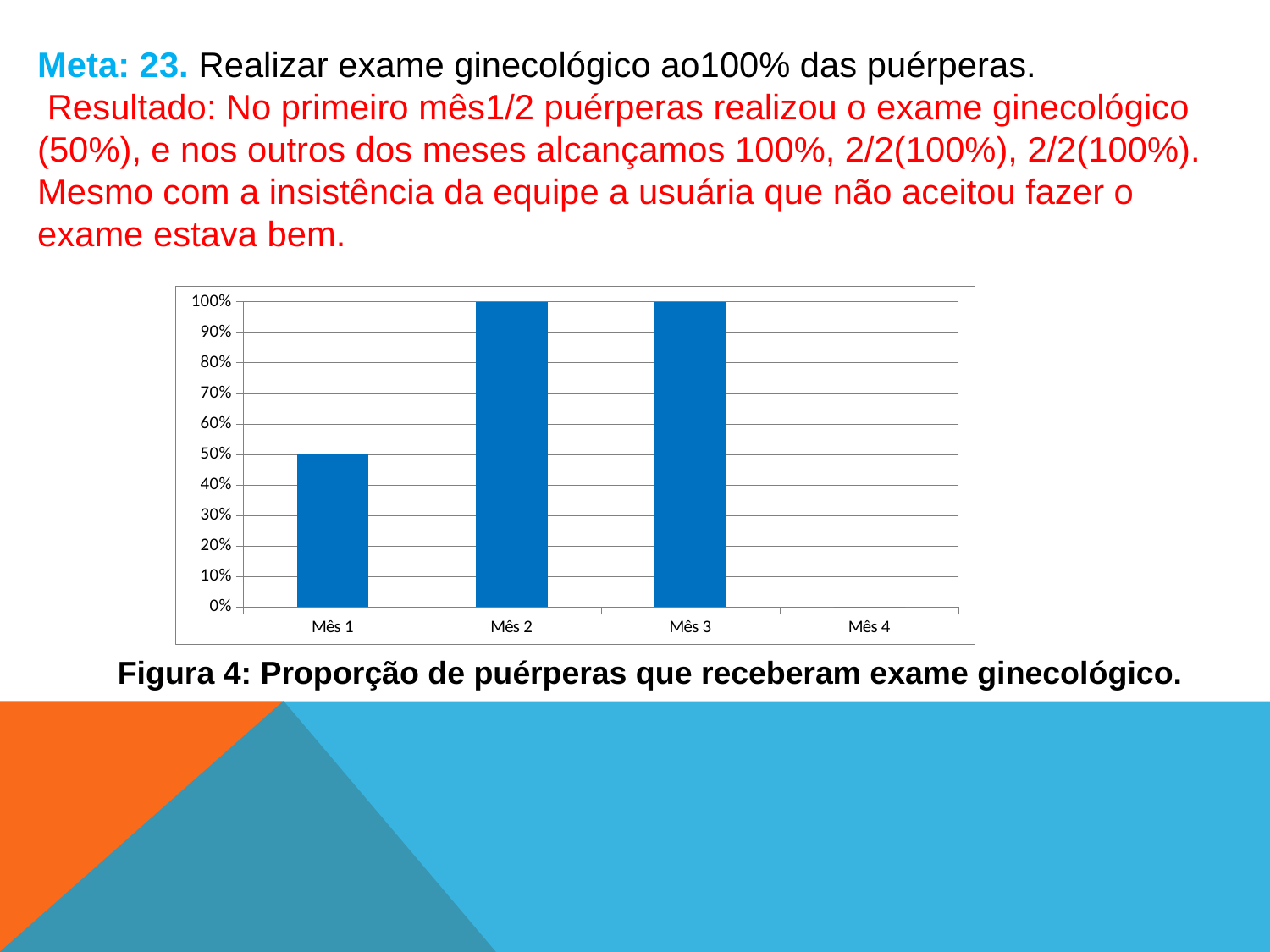
What is the value for Mês 2 in the chart? 100% Among Mês 1, Mês 2 and Mês 3, which month has the lowest value? Mês 1 What is the value for Mês 1 in the chart? 50% How many month categories are shown on the x axis of the chart? 4 What is the caption given for the chart on the slide? Figura 4: Proporção de puérperas que receberam exame ginecológico. What is the value for Mês 3 in the chart? 100% Is the value for Mês 3 greater or less than 90%? greater Is the value for Mês 1 greater or less than 60%? less Which is larger, the value for Mês 1 or the value for Mês 2? Mês 2 What kind of chart is shown on the slide? Bar chart Do the values rise or fall from Mês 1 to Mês 2? Rise What is the difference between the values for Mês 2 and Mês 1? 50%